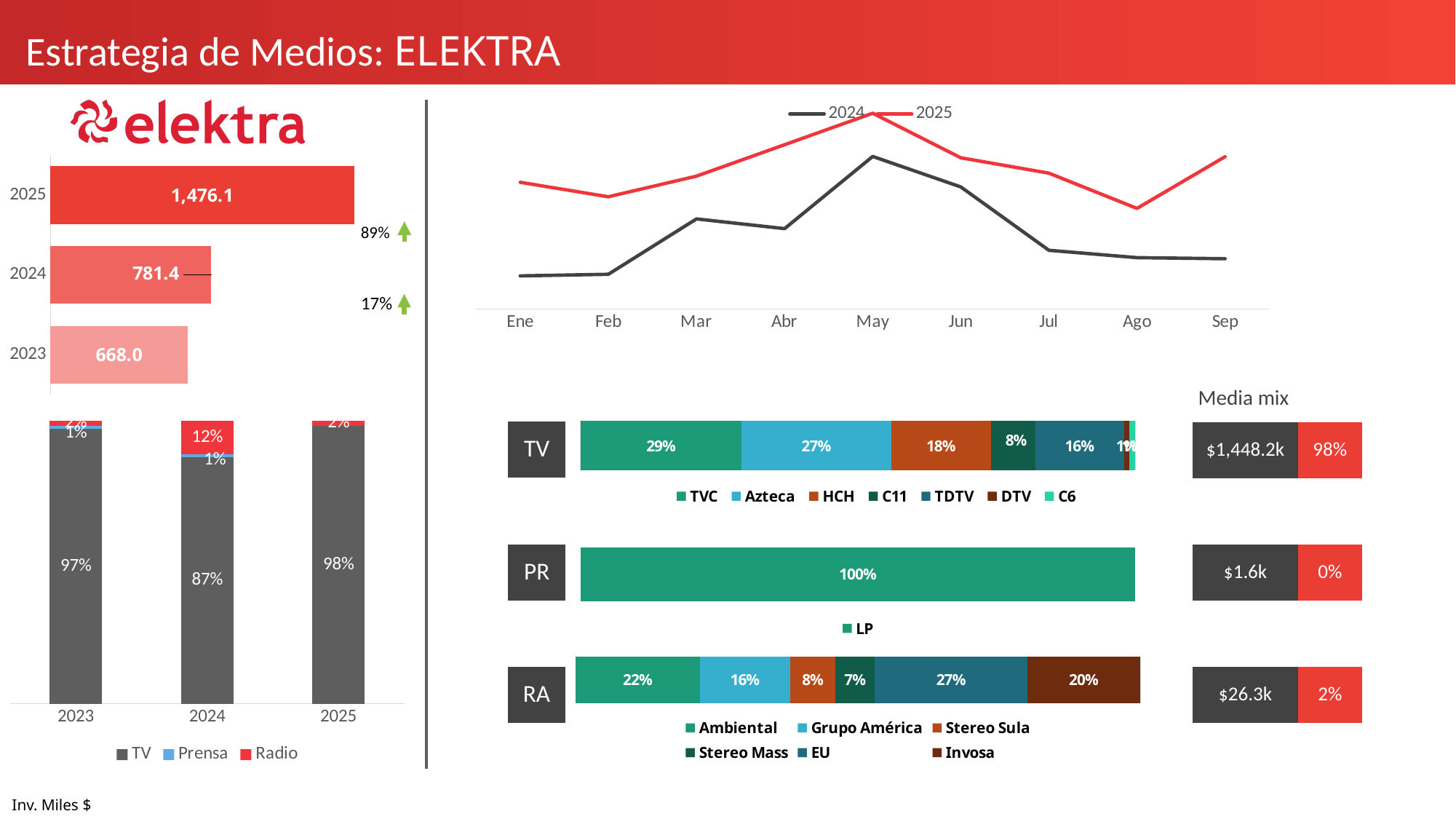
In the top-left bar chart of yearly investment, what is the difference between the 2025 and 2024 values? 694.7 In the top-right line chart comparing 2024 and 2025 by month, in which month does the 2025 line reach its highest point? May In the top-left bar chart of yearly investment, which year has the lowest value? 2023 In the TV stacked bar, what is the share for Azteca? 27% In the RA stacked bar, which station has the largest share? EU In the Media mix column, what is the dollar amount shown for RA? $26.3k In the bottom-left stacked bar chart of media share by year, how many series does the legend list? 3 In the top-left bar chart of yearly investment, what is the value for 2025? 1,476.1 In the top-right line chart comparing 2024 and 2025 by month, how many months are shown on the x axis? 9 In the bottom-left stacked bar chart of media share by year, what is the TV share for 2023? 97% In the bottom-left stacked bar chart of media share by year, what is the Radio share for 2024? 12% In the top-left bar chart of yearly investment, what is the value for 2023? 668.0